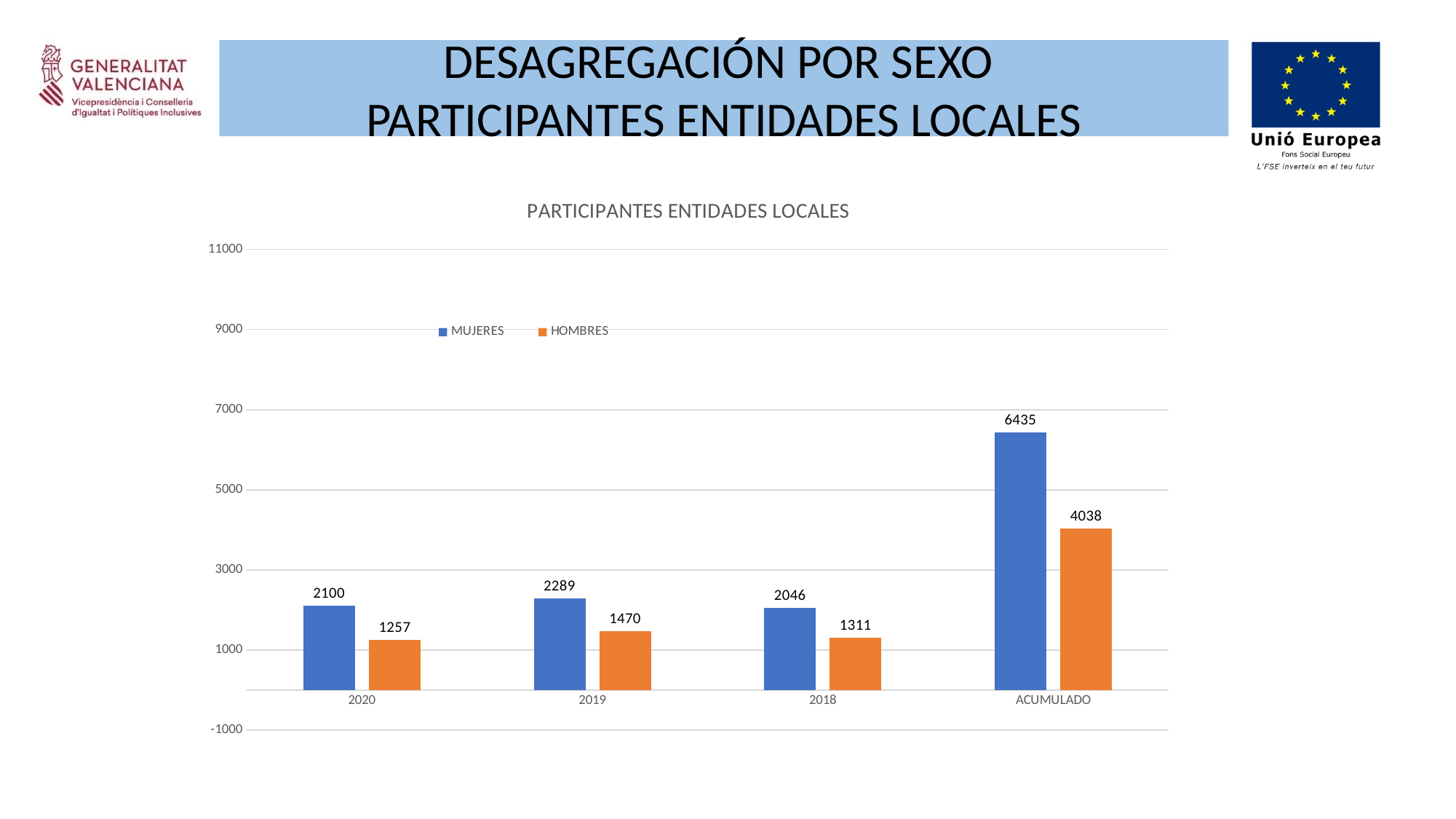
Among the years 2020, 2019 and 2018, which has the lowest HOMBRES value? 2020 What is the MUJERES value for 2020? 2100 How many series does the legend list? 2 Which is larger, the MUJERES value for 2018 or the HOMBRES value for 2019? MUJERES for 2018 What is the HOMBRES value for 2018? 1311 What is the difference between the MUJERES and HOMBRES values for ACUMULADO? 2397 What is the HOMBRES value for 2019? 1470 Is the HOMBRES value for ACUMULADO greater or less than 5000? less What kind of chart is shown? bar chart What is the MUJERES value for ACUMULADO? 6435 How many categories are shown on the x axis? 4 Among the years 2020, 2019 and 2018, which has the highest MUJERES value? 2019